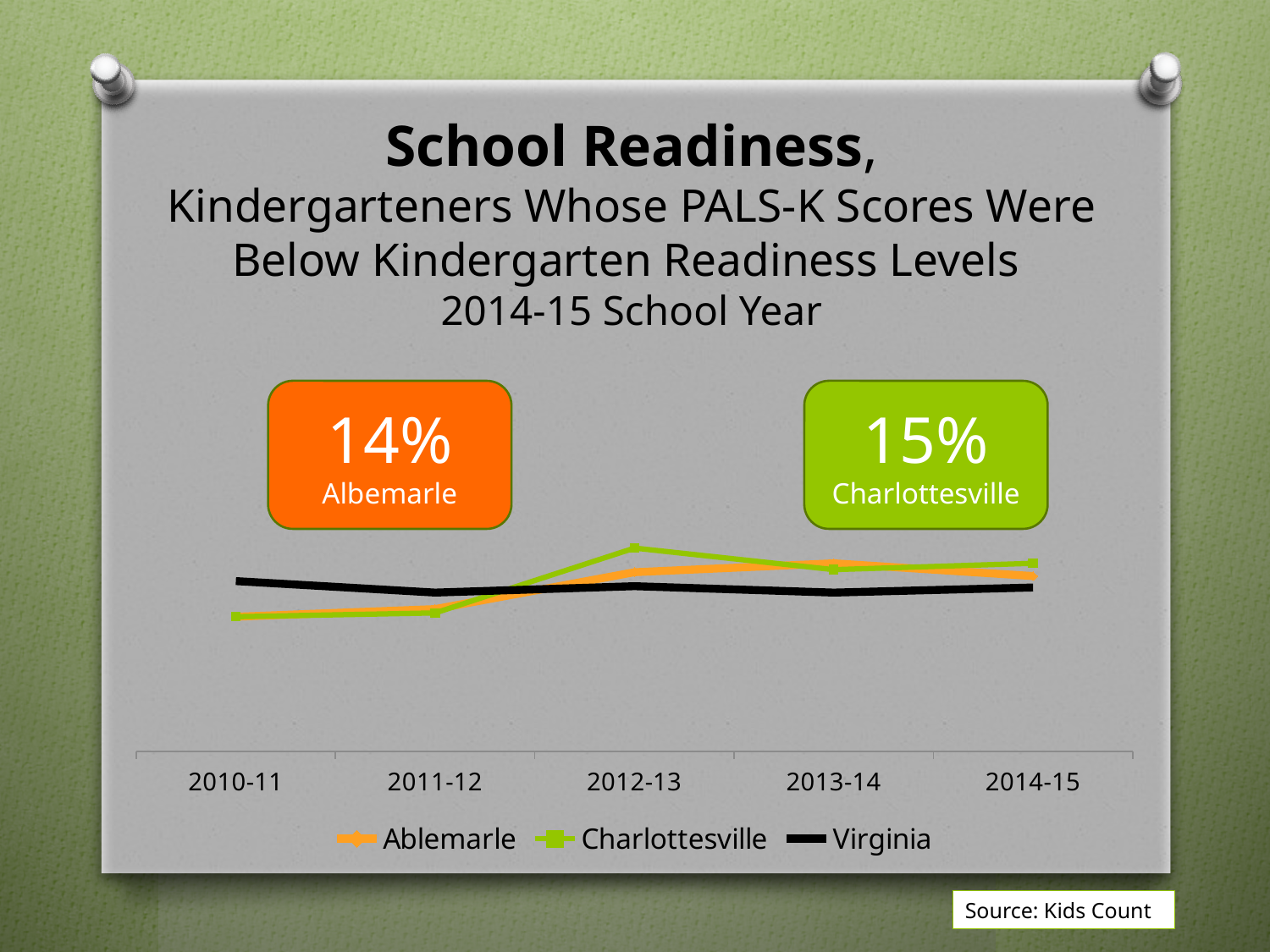
What is the difference between the Charlottesville and Albemarle percentages shown for 2014-15? 1 percentage point Which series is drawn with a black line? Virginia How many school years are shown on the x axis? 5 What source is cited for the chart? Kids Count How many series does the legend list? 3 Does the Charlottesville line rise or fall between 2010-11 and 2012-13? Rise In 2014-15, which is higher: Charlottesville or Virginia? Charlottesville In 2010-11, which is higher: Virginia or Charlottesville? Virginia What percentage is shown for Charlottesville in the 2014-15 school year? 15% Which series has the highest value in 2012-13? Charlottesville What percentage is shown for Albemarle in the 2014-15 school year? 14% What kind of chart is shown on the slide? Line chart